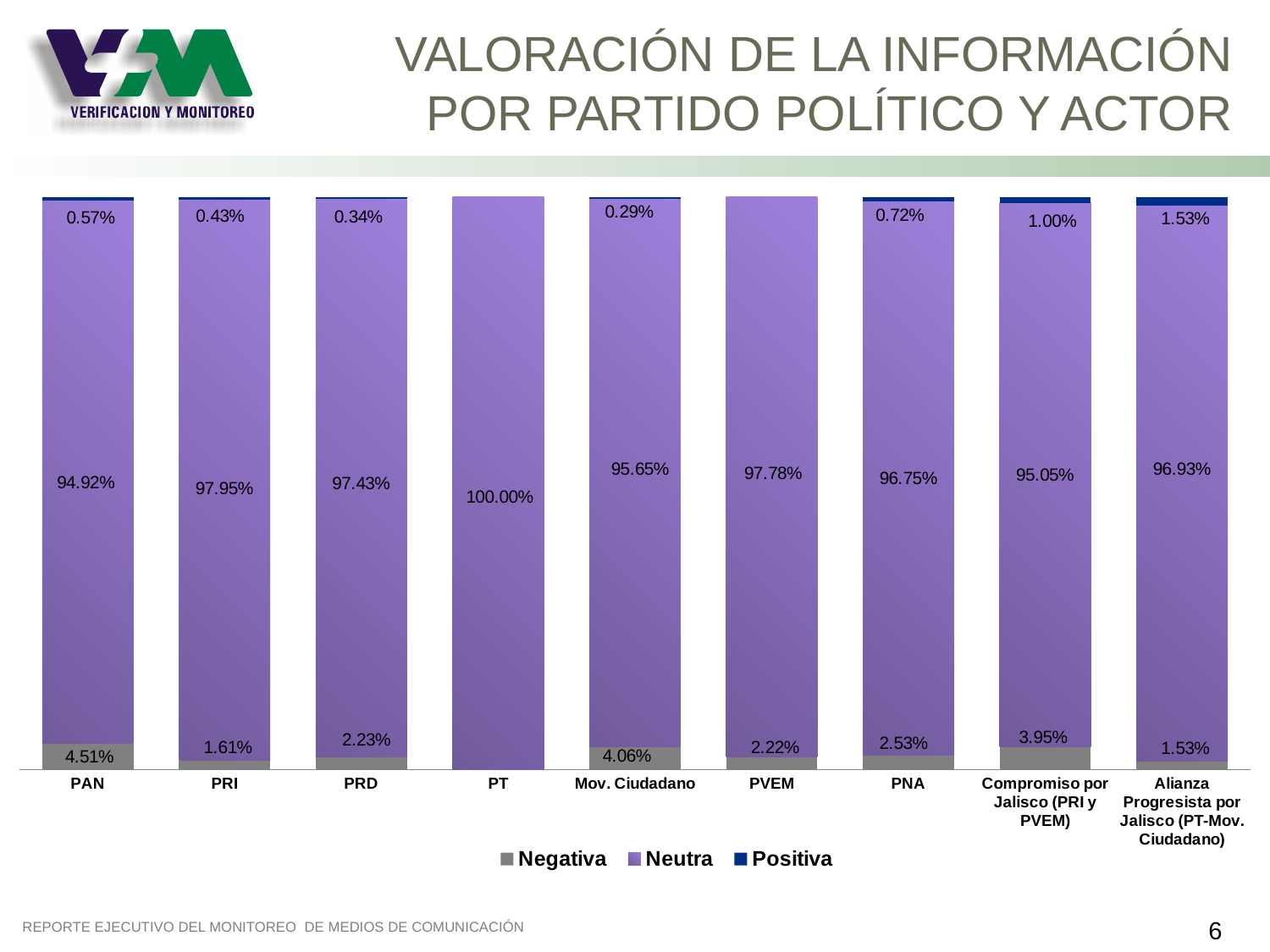
What is the Positiva value for Compromiso por Jalisco (PRI y PVEM)? 1.00% What is the difference between the Neutra values for PRI and PRD? 0.52% Which category has the lowest Neutra value? PAN What is the Neutra value for PT? 100.00% What kind of chart is shown on the slide? Stacked bar chart How many series does the legend list? 3 What is the Neutra value for PAN? 94.92% Which category has the highest Negativa value? PAN What is the Negativa value for Mov. Ciudadano? 4.06% What are the three series named in the legend? Negativa, Neutra, Positiva How many categories are shown on the x axis? 9 Which is larger, the Negativa value for PNA or the Negativa value for PVEM? PNA